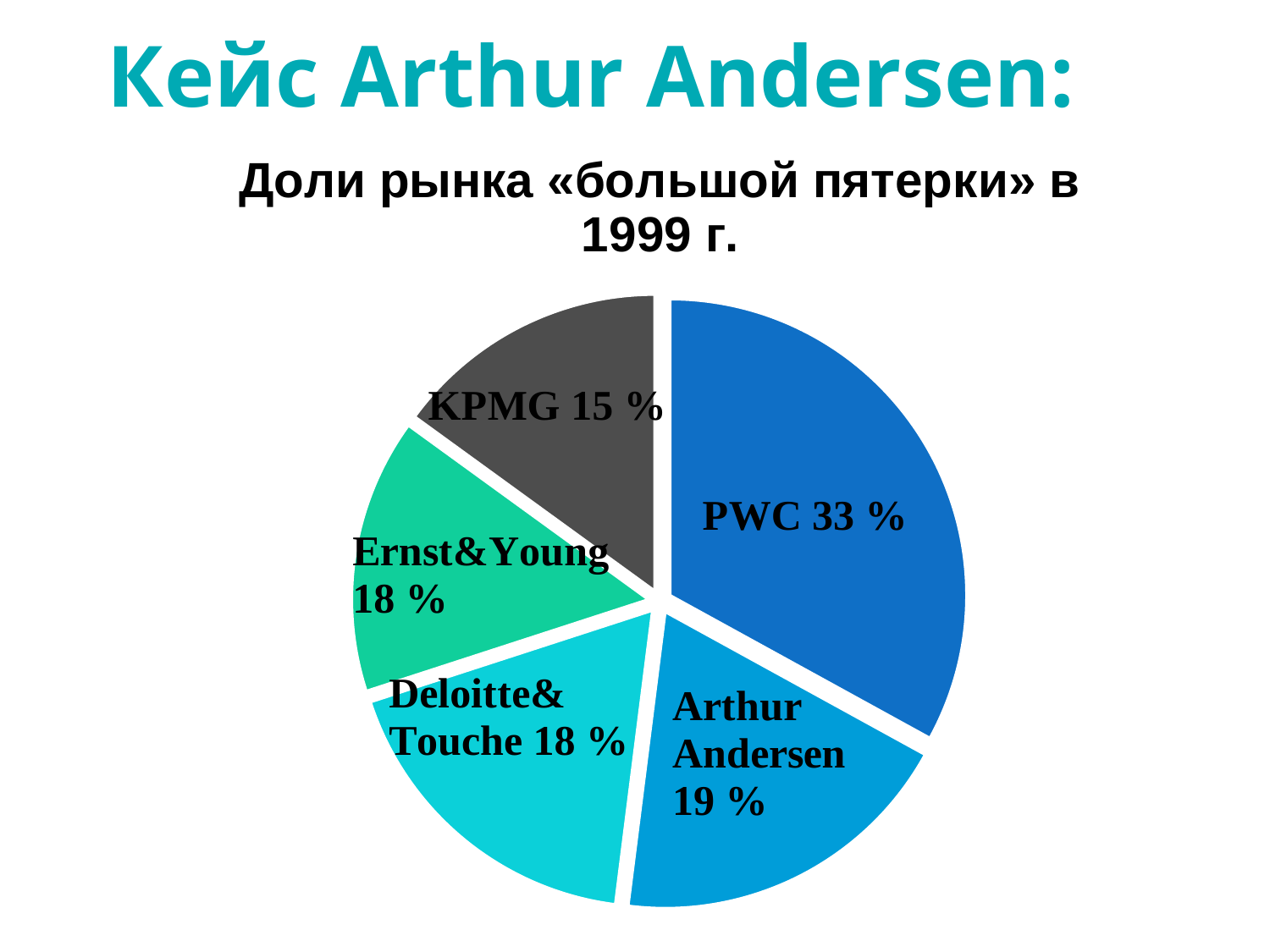
What is the market share shown for Arthur Andersen? 19 % Which has the larger share, PWC or Deloitte&Touche? PWC Which firm has the smallest slice of the pie? KPMG How many firms are shown in the pie chart? 5 What type of chart is shown on the slide? Pie chart What is the market share shown for KPMG? 15 % What is the market share shown for Ernst&Young? 18 % What is the market share shown for PWC? 33 % What is the difference between the shares of PWC and Arthur Andersen? 14 % What is the title of the chart? Доли рынка «большой пятерки» в 1999 г. What is the difference between the shares of Arthur Andersen and KPMG? 4 % Which firm has the largest slice of the pie? PWC